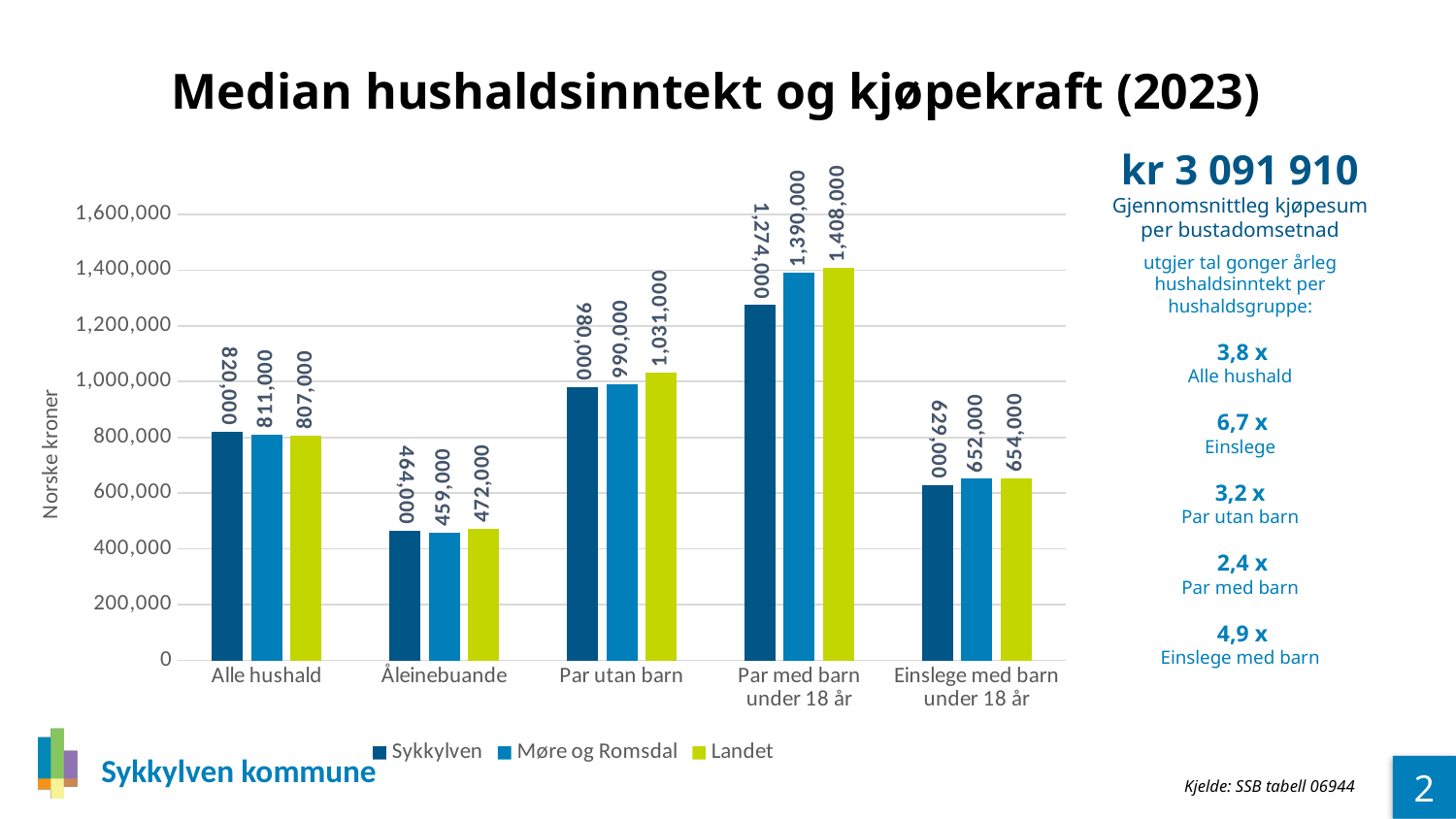
What is the value for Møre og Romsdal in the Åleinebuande category? 459,000 What is the value for Landet in the Par med barn under 18 år category? 1,408,000 Which category has the lowest value for Landet? Åleinebuande What is the title of the chart on the slide? Median hushaldsinntekt og kjøpekraft (2023) What is the value for Sykkylven in the Alle hushald category? 820,000 What kind of chart is shown on the slide? bar chart Which category has the highest value for Sykkylven? Par med barn under 18 år What is the difference between the Landet and Sykkylven values in the Par med barn under 18 år category? 134,000 Is the value for Møre og Romsdal in the Einslege med barn under 18 år category greater or less than 800,000? less In the Par utan barn category, which is larger: the value for Sykkylven or the value for Landet? Landet How many series does the legend list? 3 How many household categories are shown on the x axis? 5